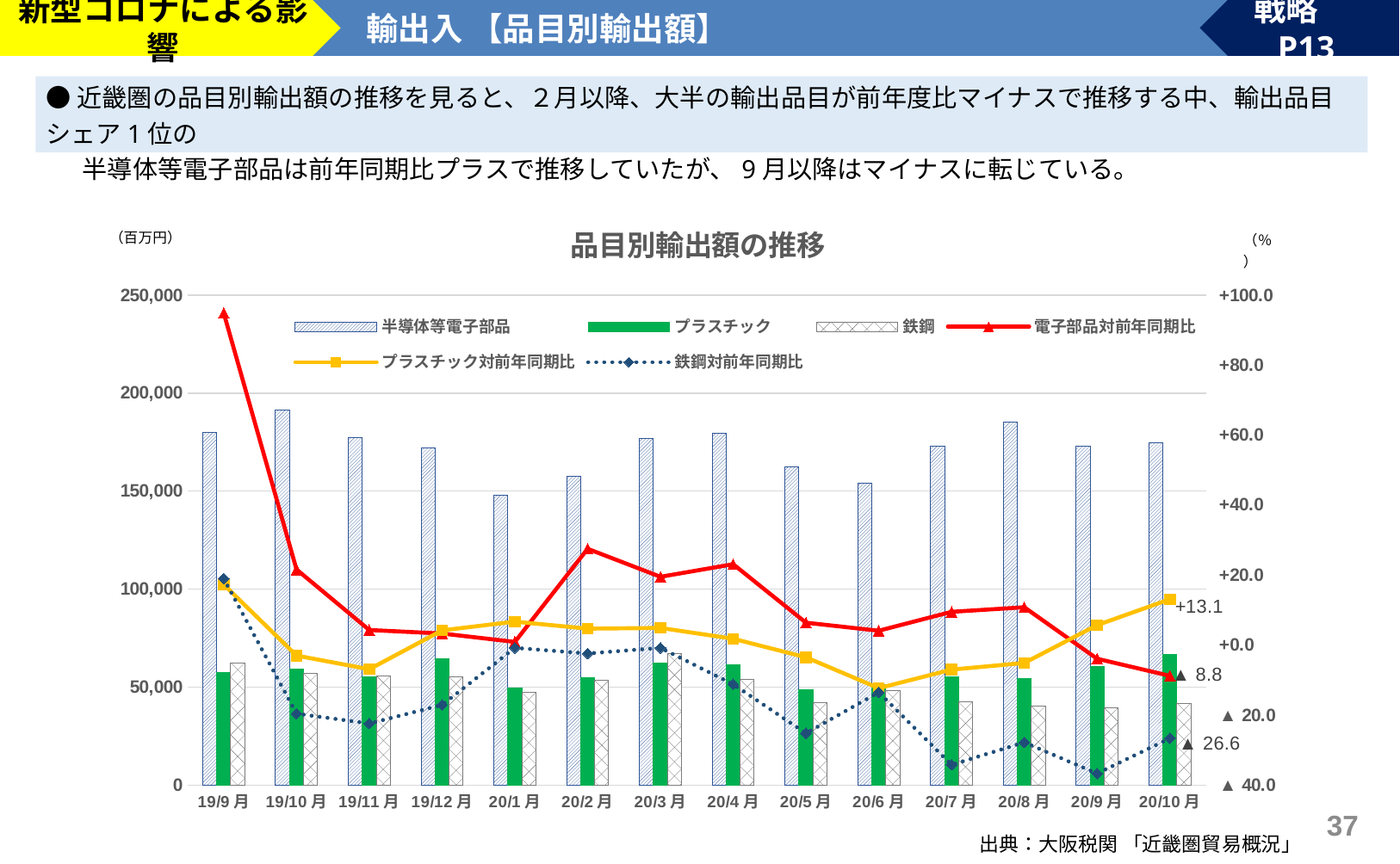
In 19/9月, which is larger: the 半導体等電子部品 bar or the プラスチック bar? 半導体等電子部品 How many months are shown along the x axis of the chart? 14 What is the value of プラスチック対前年同期比 for 20/10月? +13.1 Is the value for プラスチック in 20/10月 greater or less than 50,000? greater How many series does the legend of the chart list? 6 What is the title of the chart? 品目別輸出額の推移 What is the value of 鉄鋼対前年同期比 for 20/10月? ▲26.6 In which month is the 半導体等電子部品 bar the highest? 19/10月 What is the value of 電子部品対前年同期比 for 20/10月? ▲8.8 In which month does the 電子部品対前年同期比 line reach its highest value? 19/9月 Is the value for 半導体等電子部品 in 19/10月 greater or less than 150,000? greater What kind of chart is shown on the slide? A combined bar and line chart